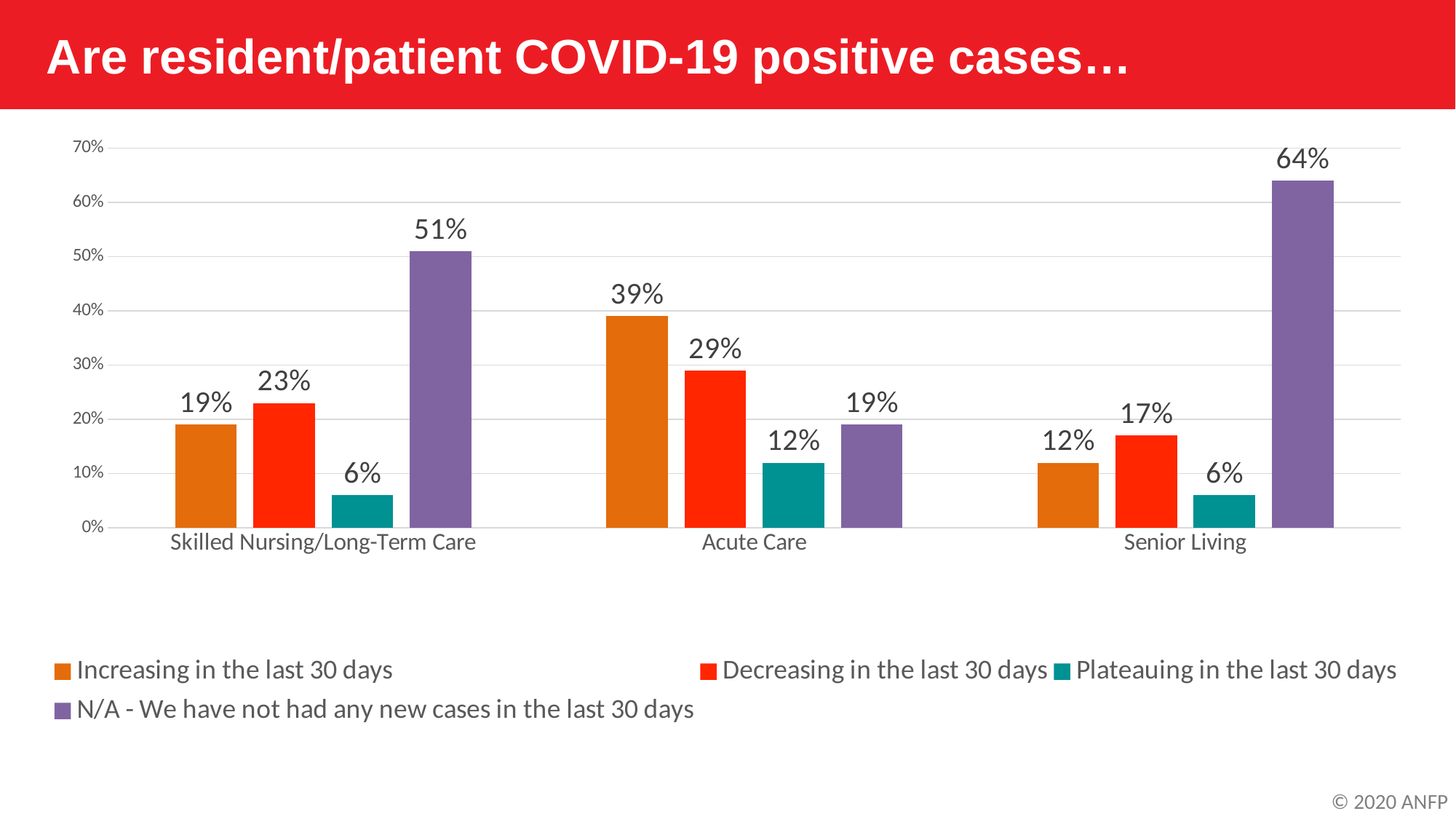
How many series does the legend list? 4 What percentage of Acute Care respondents reported cases increasing in the last 30 days? 39% What percentage of Skilled Nursing/Long-Term Care respondents reported cases decreasing in the last 30 days? 23% What kind of chart is shown on the slide? Bar chart What is the difference between the 'Increasing in the last 30 days' values for Acute Care and Skilled Nursing/Long-Term Care? 20% Is the 'N/A - We have not had any new cases in the last 30 days' value for Skilled Nursing/Long-Term Care greater or less than 40%? greater Which category has the lowest value for 'Increasing in the last 30 days'? Senior Living For Acute Care, which is larger: 'Decreasing in the last 30 days' or 'Plateauing in the last 30 days'? Decreasing in the last 30 days What is the value for 'N/A - We have not had any new cases in the last 30 days' for Senior Living? 64% What colour represents 'Plateauing in the last 30 days' in the legend? Teal How many categories are shown on the x axis? 3 Which category has the highest value for 'N/A - We have not had any new cases in the last 30 days'? Senior Living